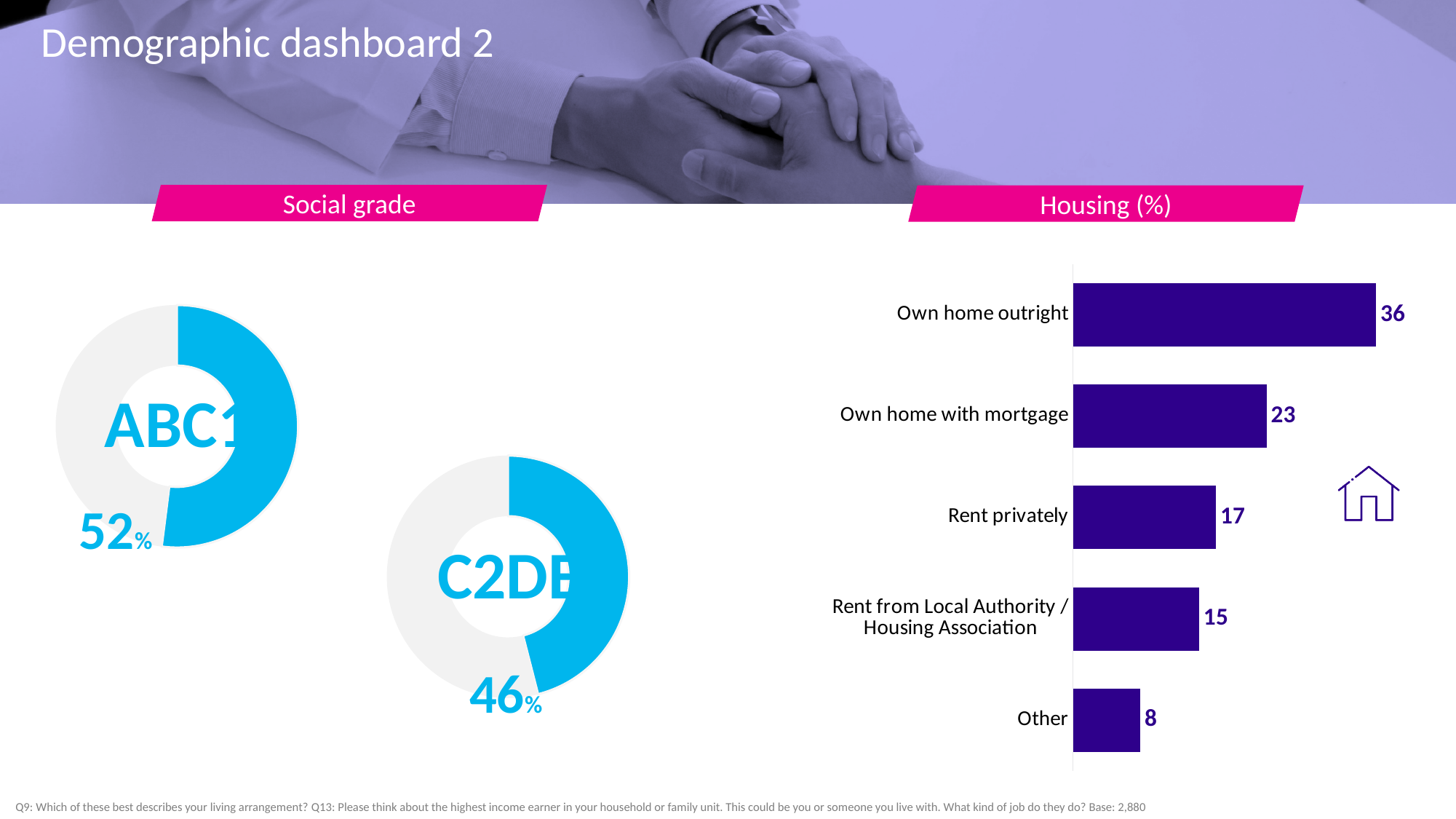
In the Housing (%) chart, which is larger: Rent privately or Other? Rent privately In the Housing (%) chart, what is the difference between Own home outright and Own home with mortgage? 13 In the Housing (%) chart, what is the value for Rent privately? 17 In the Social grade section, what percentage is shown for C2DE? 46% In the Housing (%) chart, what is the value for Rent from Local Authority / Housing Association? 15 In the Social grade section, what percentage is shown for ABC1? 52% In the Housing (%) chart, what is the value for Own home outright? 36 In the Housing (%) chart, which category has the lowest value? Other In the Social grade section, which group has the larger share: ABC1 or C2DE? ABC1 In the Housing (%) chart, which category has the highest value? Own home outright How many categories are shown in the Housing (%) chart? 5 What kind of chart is the Housing (%) chart? Bar chart